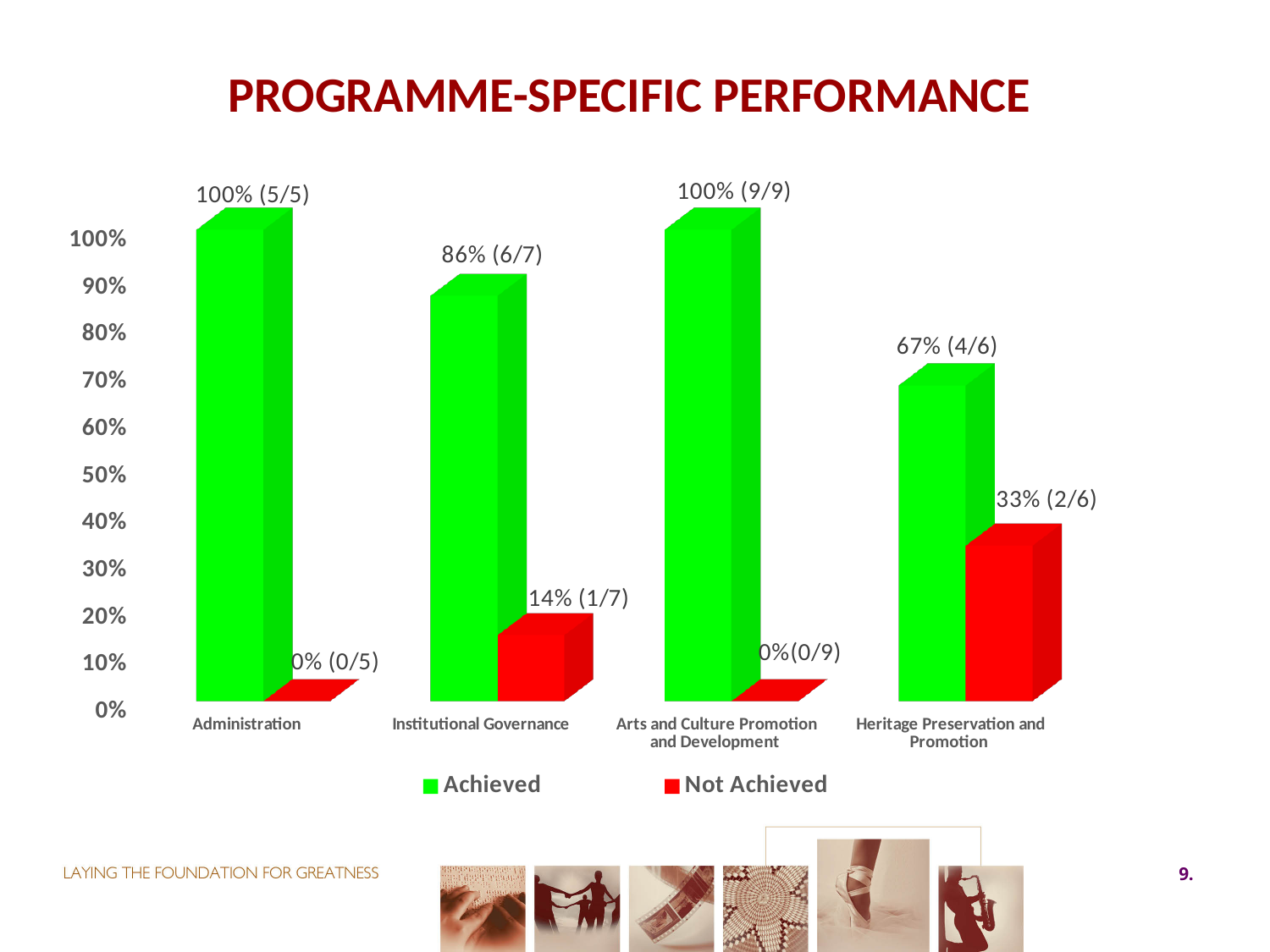
What is the Not Achieved value for Heritage Preservation and Promotion? 33% (2/6) Which is larger, the Achieved value for Institutional Governance or the Achieved value for Heritage Preservation and Promotion? Institutional Governance What kind of chart is shown on the slide? Bar chart Which programme has the lowest Achieved percentage? Heritage Preservation and Promotion How many programmes (categories) are shown on the x axis? 4 Which programme has the highest Not Achieved percentage? Heritage Preservation and Promotion What is the difference in Achieved percentage between Administration and Institutional Governance? 14% What is the Not Achieved value for Institutional Governance? 14% (1/7) What is the Achieved value for Institutional Governance? 86% (6/7) What colour represents the Not Achieved series? Red How many series does the legend list? 2 What is the Achieved value for Heritage Preservation and Promotion? 67% (4/6)